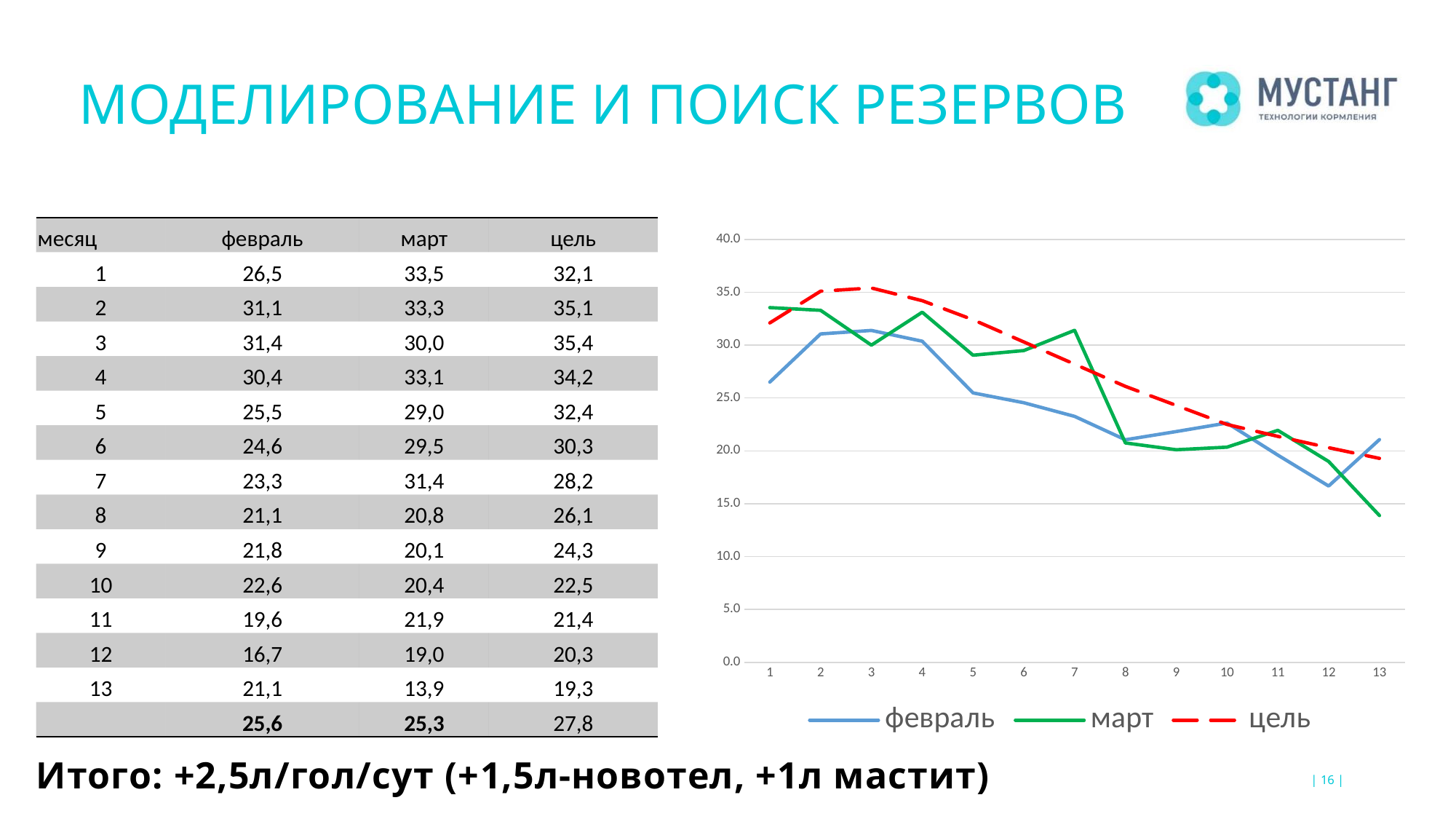
What is the value of the март series at month 13? 13,9 At which month does the март series reach its lowest value? 13 How many series does the chart legend list? 3 What kind of chart is shown on the slide? line chart Which series is drawn as a red dashed line in the chart? цель At month 7, which series has the larger value: февраль or март? март At which month does the цель series reach its highest value? 3 What is the value of the цель series at month 1? 32,1 How many months (points) are plotted along the x axis of the chart? 13 Is the value of the февраль series at month 12 greater or less than 20.0? less What is the difference between the февраль and март values at month 13? 7,2 Does the цель series rise or fall from month 3 to month 13? falls